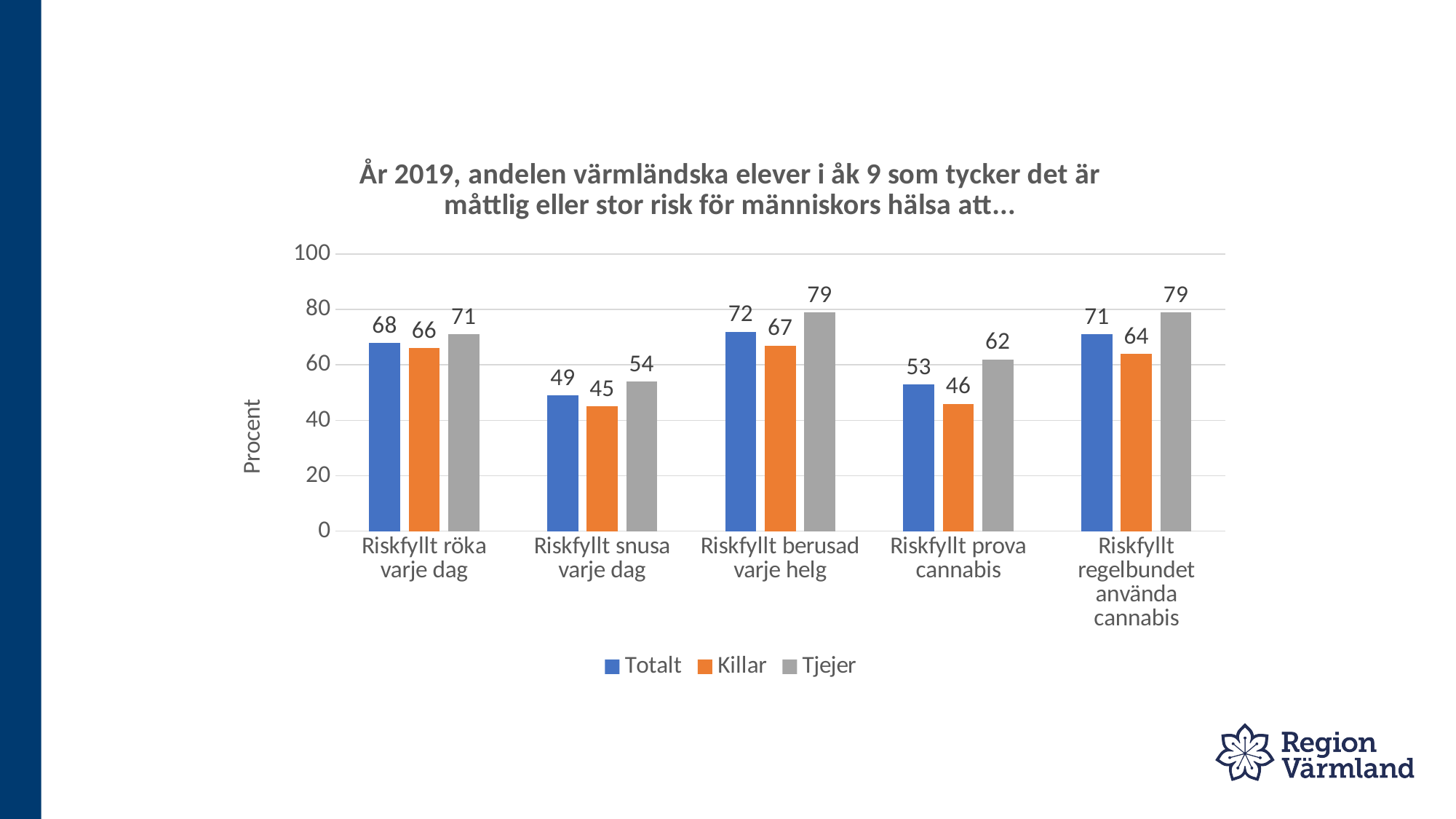
What is the Totalt value for 'Riskfyllt röka varje dag'? 68 What is the label on the y axis? Procent What is the Killar value for 'Riskfyllt snusa varje dag'? 45 Which category has the highest Killar value? Riskfyllt berusad varje helg Which is larger for 'Riskfyllt regelbundet använda cannabis': the Killar value or the Tjejer value? Tjejer Is the Totalt value for 'Riskfyllt berusad varje helg' greater or less than 60? greater What is the Tjejer value for 'Riskfyllt prova cannabis'? 62 How many series does the legend list? 3 How many categories are shown on the x axis? 5 What is the difference between the Tjejer and Killar values for 'Riskfyllt prova cannabis'? 16 Which category has the lowest Totalt value? Riskfyllt snusa varje dag What kind of chart is shown on the slide? bar chart